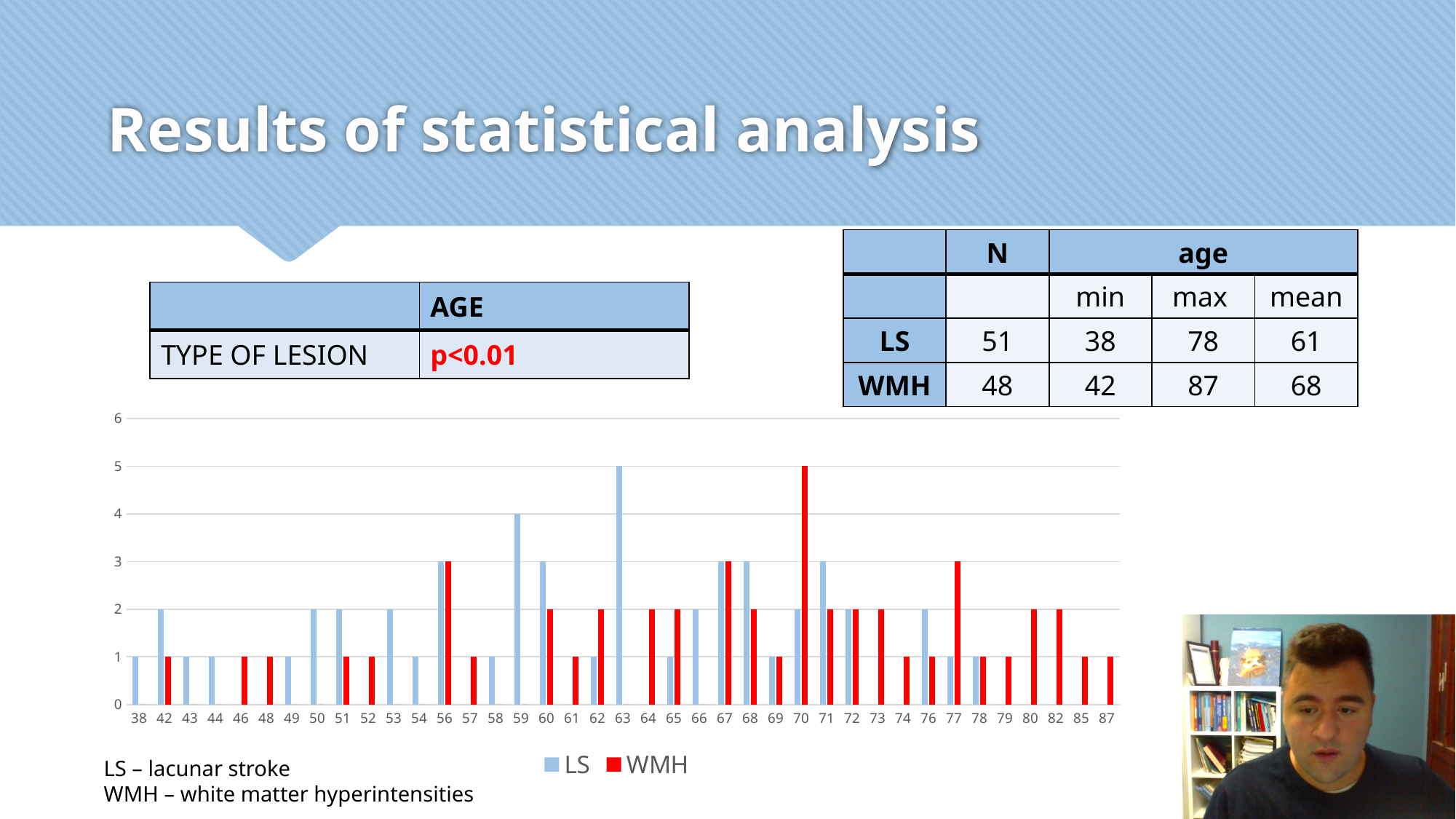
How many age categories are shown on the x axis of the chart? 39 At which age does the LS series reach its highest value in the chart? 63 Which colour represents the WMH series in the chart? red What is the LS value at age 63 in the chart? 5 What are the two series named in the chart legend? LS and WMH How many series does the chart legend list? 2 At which age does the WMH series reach its highest value in the chart? 70 What is the WMH value at age 77 in the chart? 3 In the chart, what is the difference between the LS value at age 63 and the WMH value at age 62? 3 What kind of chart is shown on the slide? bar chart What is the LS value at age 59 in the chart? 4 In the chart, which is larger at age 70, the LS value or the WMH value? WMH